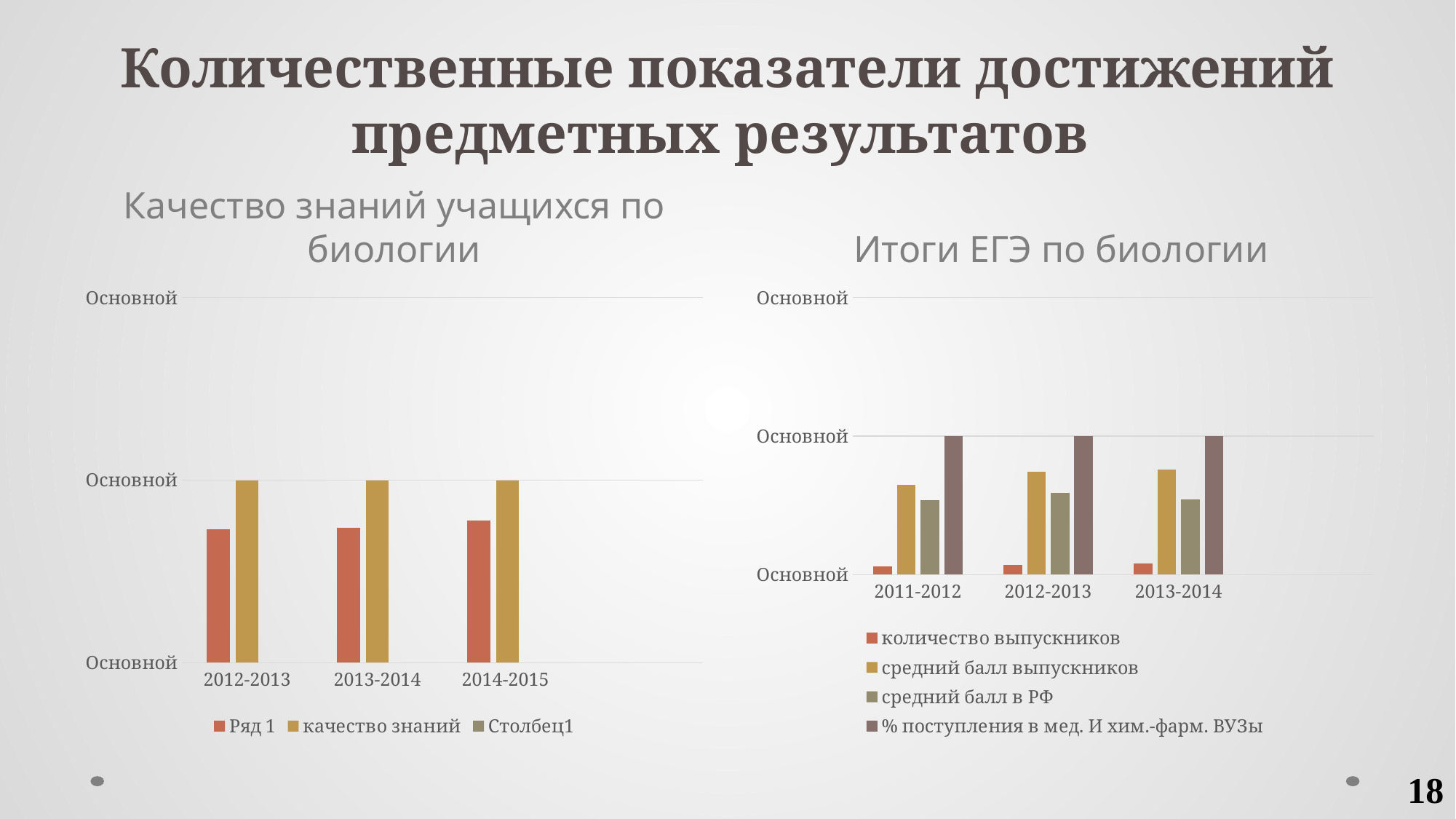
How many categories are shown on the x axis of the right chart, "Итоги ЕГЭ по биологии"? 3 How many categories are shown on the x axis of the left chart, "Качество знаний учащихся по биологии"? 3 What is the title of the right chart on the slide? Итоги ЕГЭ по биологии In the right chart, "Итоги ЕГЭ по биологии", do the values of "средний балл выпускников" rise or fall from 2011-2012 to 2013-2014? rise In the right chart, "Итоги ЕГЭ по биологии", which is larger in 2012-2013: "средний балл выпускников" or "средний балл в РФ"? средний балл выпускников In the left chart, "Качество знаний учащихся по биологии", do the values of the series "Ряд 1" rise or fall from 2012-2013 to 2014-2015? rise In the left chart, "Качество знаний учащихся по биологии", which series has the larger value in 2013-2014: "Ряд 1" or "качество знаний"? качество знаний How many series does the legend of the right chart, "Итоги ЕГЭ по биологии", list? 4 In the right chart, "Итоги ЕГЭ по биологии", which series has the lowest value in 2013-2014? количество выпускников What kind of chart is the left chart, "Качество знаний учащихся по биологии"? bar chart In the right chart, "Итоги ЕГЭ по биологии", which series has the highest value in 2011-2012? % поступления в мед. И хим.-фарм. ВУЗы How many series does the legend of the left chart, "Качество знаний учащихся по биологии", list? 3